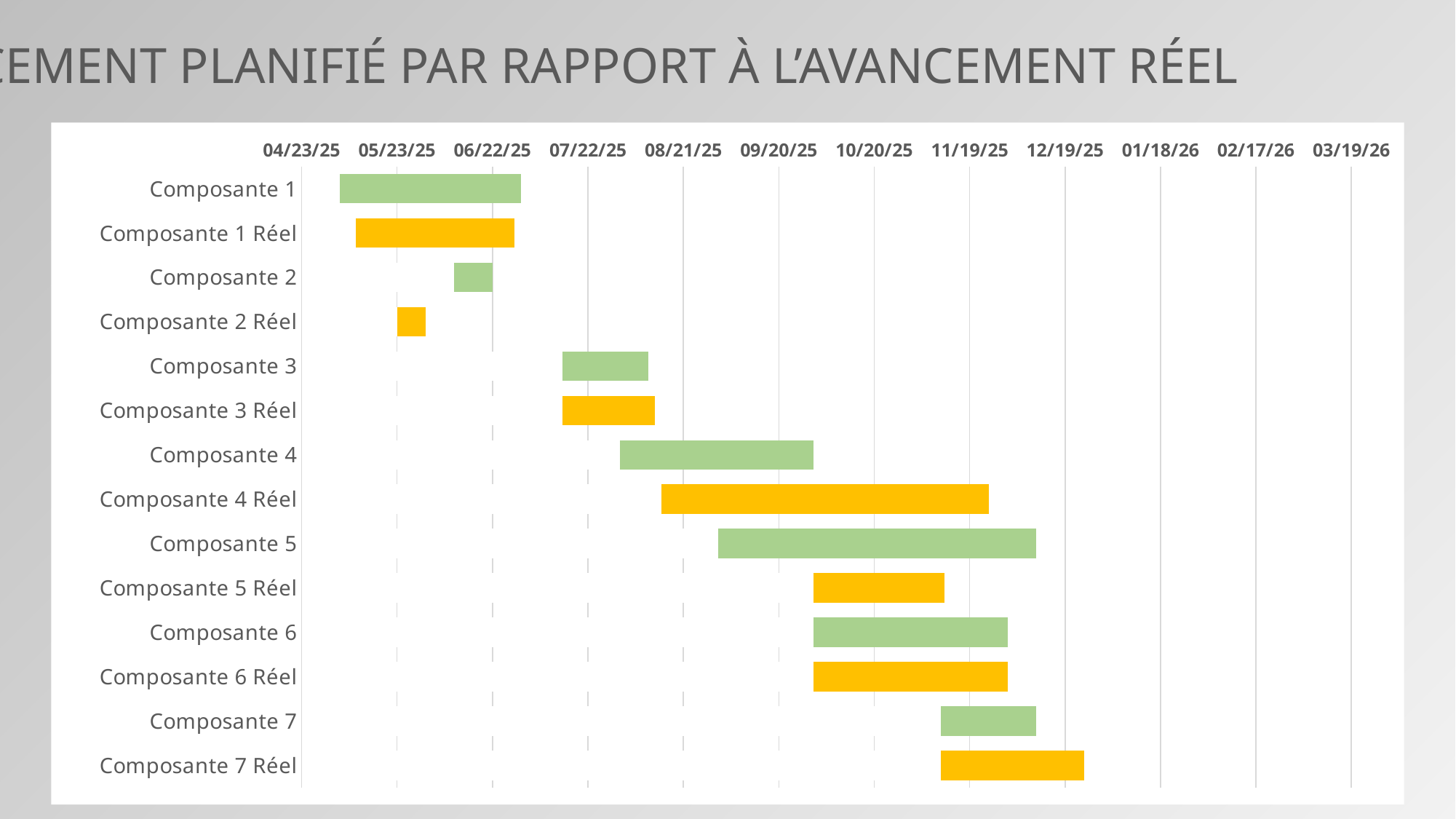
What kind of chart is shown on the slide? Bar chart (Gantt chart) How many 'Réel' rows are plotted on the chart? 7 Does the bar for Composante 1 start before or after 05/23/25? before What colour are the 'Réel' bars on the chart? Orange/yellow Which bar is longer, Composante 4 or Composante 4 Réel? Composante 4 Réel Which row's bar starts earliest on the chart? Composante 1 Which bar is longer, Composante 5 or Composante 5 Réel? Composante 5 Which bar is longer, Composante 7 or Composante 7 Réel? Composante 7 Réel Which row's bar ends latest on the chart? Composante 7 Réel Which row has the shortest bar on the chart? Composante 2 Réel How many categories (rows) are plotted on the chart? 14 Does the bar for Composante 7 Réel end before or after 12/19/25? after